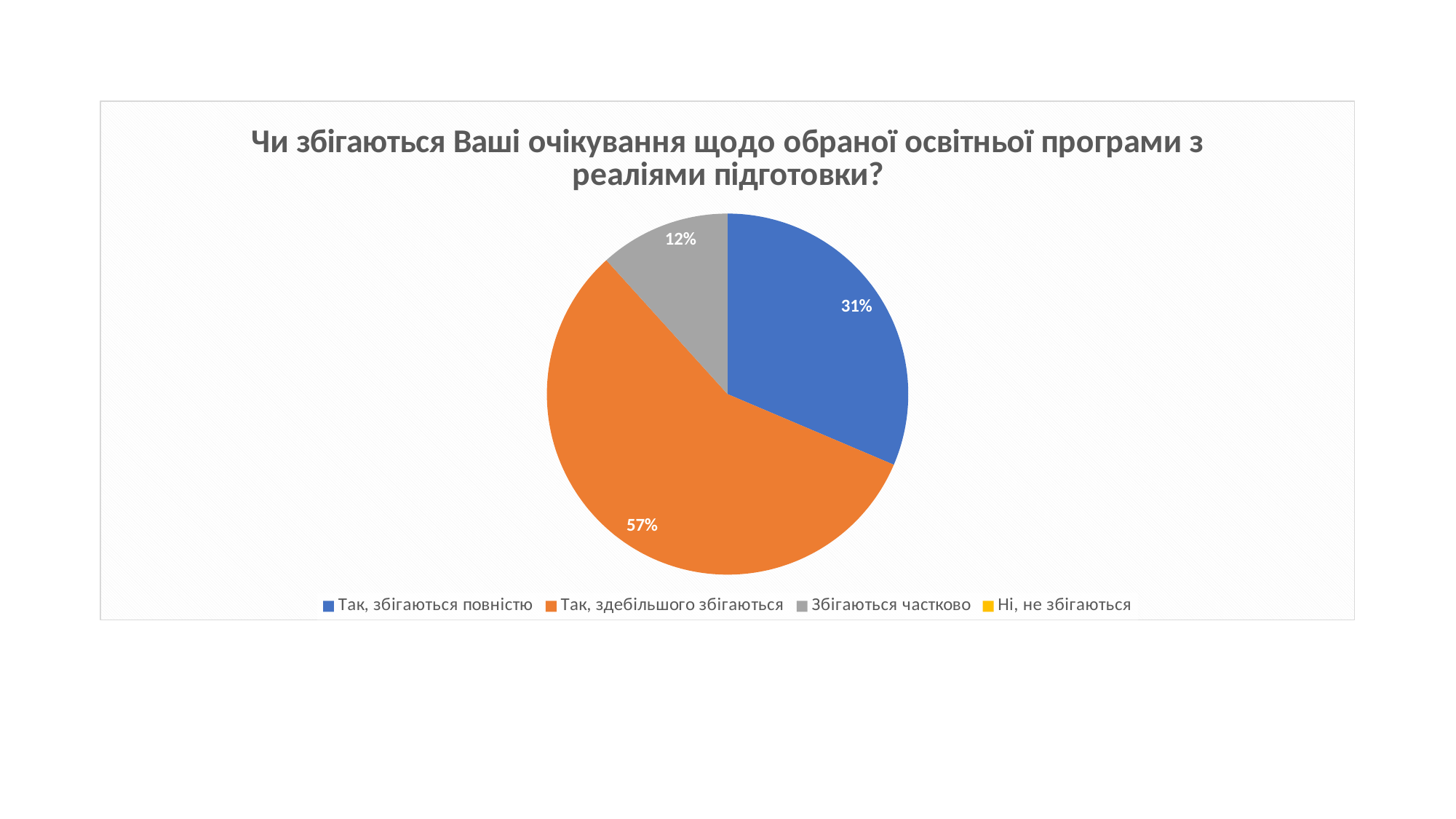
What is the title of the chart? Чи збігаються Ваші очікування щодо обраної освітньої програми з реаліями підготовки? How many answer options does the legend list? 4 Which answer option has the largest share of the pie? Так, здебільшого збігаються What is the difference in percentage points between "Так, здебільшого збігаються" and "Так, збігаються повністю"? 26 What share of the pie does the orange slice represent? 57% What percentage of respondents answered "Так, здебільшого збігаються"? 57% What colour is the slice for "Збігаються частково"? grey What percentage of respondents answered "Так, збігаються повністю"? 31% Which is larger: the share for "Так, збігаються повністю" or the share for "Збігаються частково"? Так, збігаються повністю What is the difference in percentage points between "Так, збігаються повністю" and "Збігаються частково"? 19 What percentage of respondents answered "Збігаються частково"? 12% What kind of chart is shown on the slide? pie chart